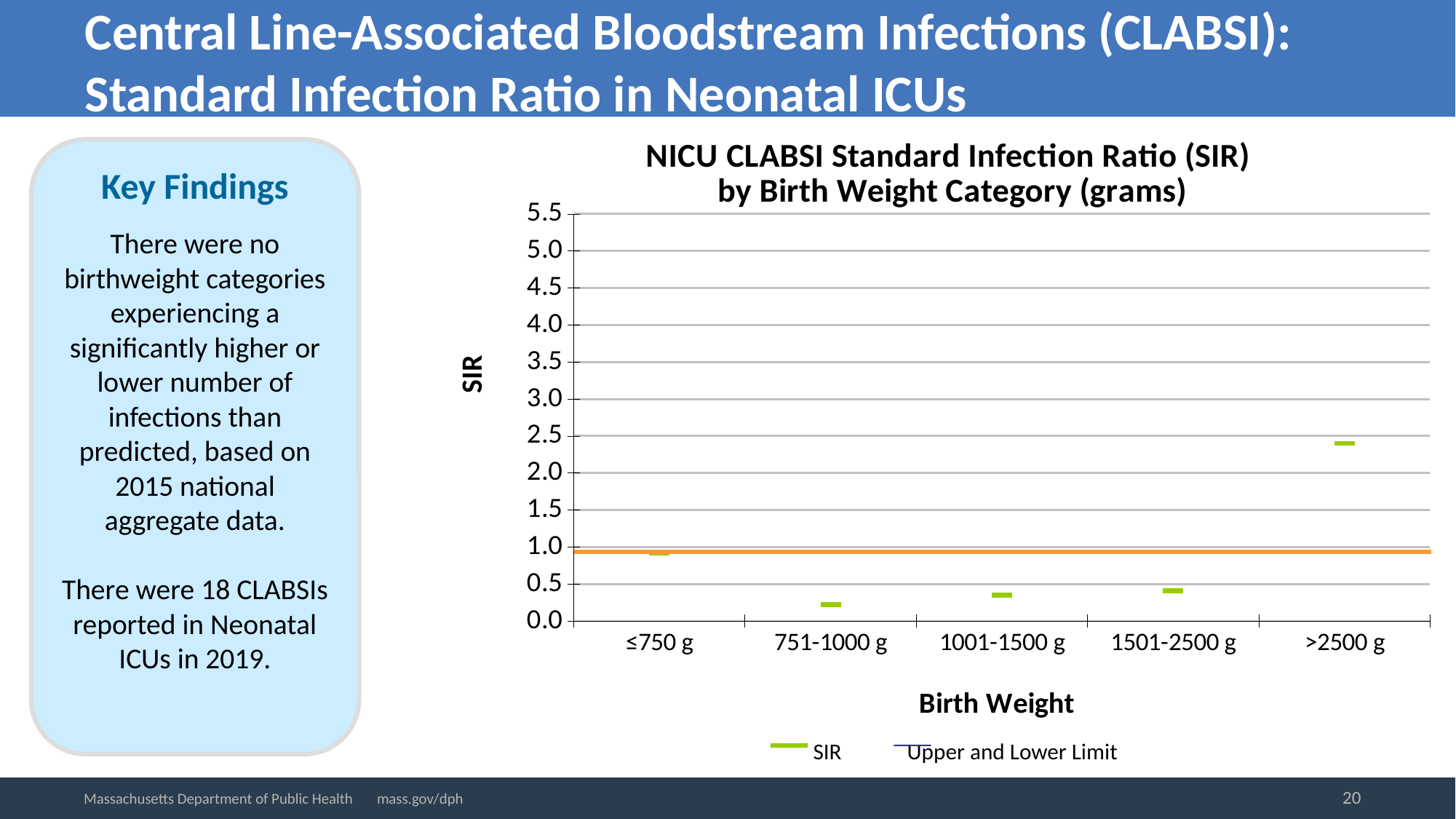
Which birth weight category has the highest SIR? >2500 g Is the SIR for 751-1000 g greater or less than 0.5? less What is the title of the y axis? SIR How many series does the legend list? 2 Is the SIR for >2500 g greater or less than 2.0? greater Is the SIR for ≤750 g greater or less than 0.5? greater Which has a larger SIR, ≤750 g or 1501-2500 g? ≤750 g Which birth weight category has the lowest SIR? 751-1000 g How many birth weight categories are shown on the x axis? 5 Which has a larger SIR, >2500 g or ≤750 g? >2500 g